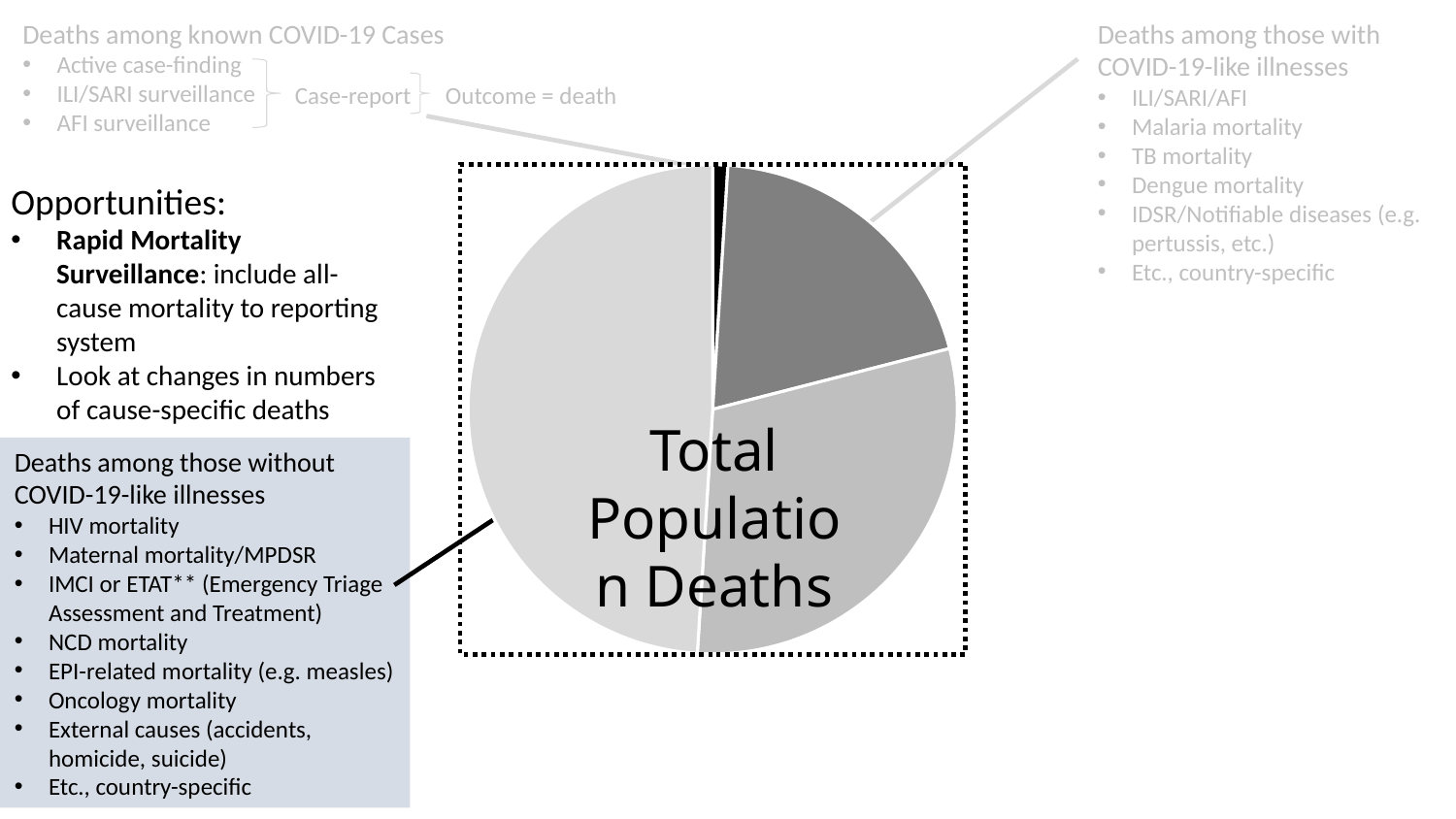
What is the title printed in the centre of the pie chart? Total Population Deaths How many slices does the pie chart have? 4 Which slice is larger: deaths among those without COVID-19-like illnesses or deaths among those with COVID-19-like illnesses? Deaths among those without COVID-19-like illnesses Which category has the smallest slice of the pie chart? Deaths among known COVID-19 Cases What kind of chart is shown on the slide? Pie chart What colour is the slice representing deaths among known COVID-19 cases? Black Which slice is larger: deaths among known COVID-19 cases or deaths among those with COVID-19-like illnesses? Deaths among those with COVID-19-like illnesses Which category has the largest slice of the pie chart? Deaths among those without COVID-19-like illnesses Does the pie chart have a legend? No